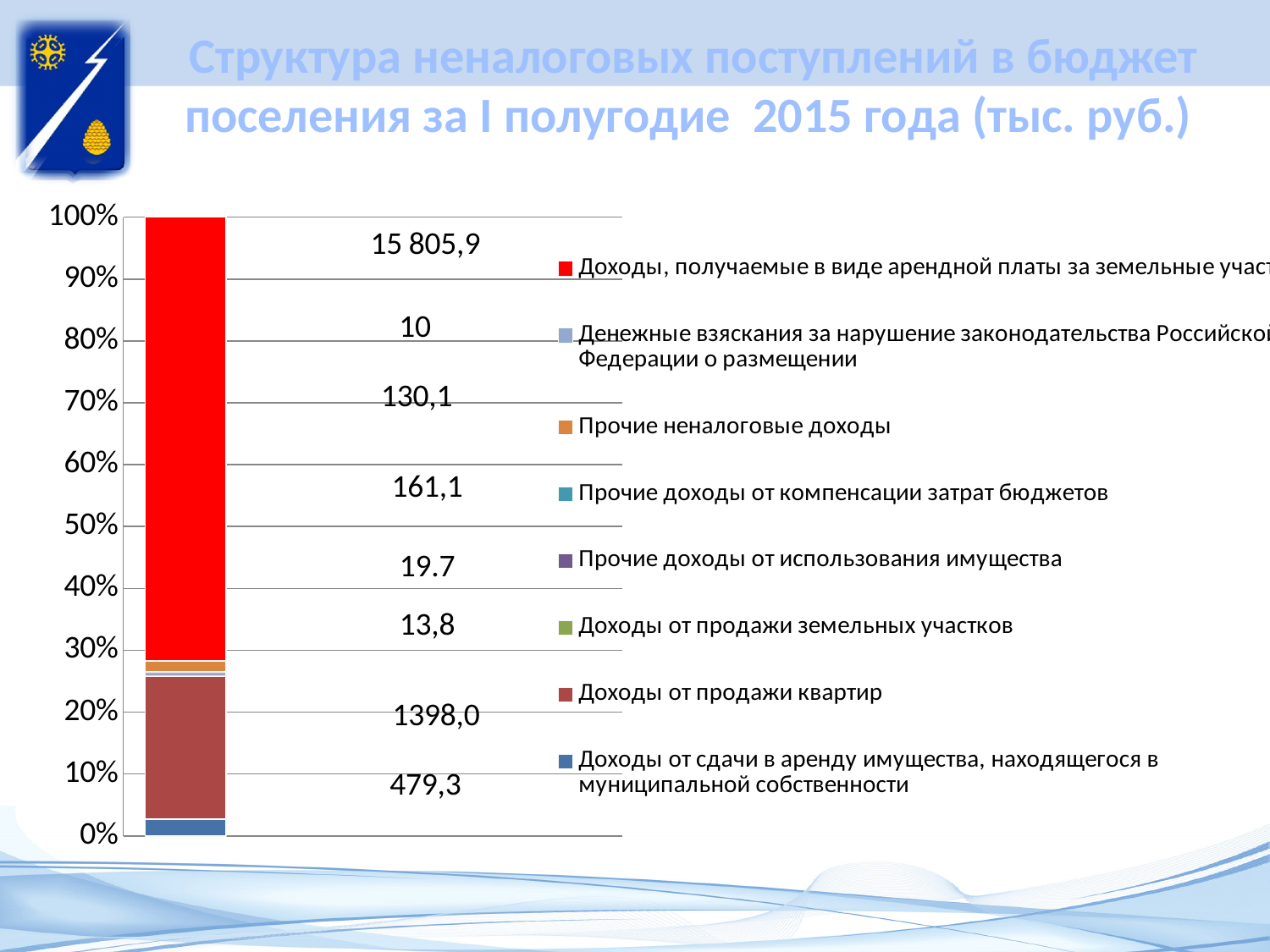
What value is shown for Прочие неналоговые доходы? 130,1 What value is shown for Доходы от сдачи в аренду имущества, находящегося в муниципальной собственности? 479,3 What is the difference between the values for Доходы от продажи квартир and Доходы от сдачи в аренду имущества, находящегося в муниципальной собственности? 918,7 Which is larger: Прочие доходы от компенсации затрат бюджетов or Прочие неналоговые доходы? Прочие доходы от компенсации затрат бюджетов What value is shown for Доходы от продажи квартир? 1398,0 What value is shown for Прочие доходы от компенсации затрат бюджетов? 161,1 What kind of chart is shown on the slide? Stacked bar chart What value is shown for Доходы от продажи земельных участков? 13,8 Which series has the smallest labelled value? Денежные взыскания за нарушение законодательства Российской Федерации о размещении What colour represents Прочие неналоговые доходы in the legend? Orange What is the largest value labelled on the chart? 15 805,9 How many series does the legend list? 8